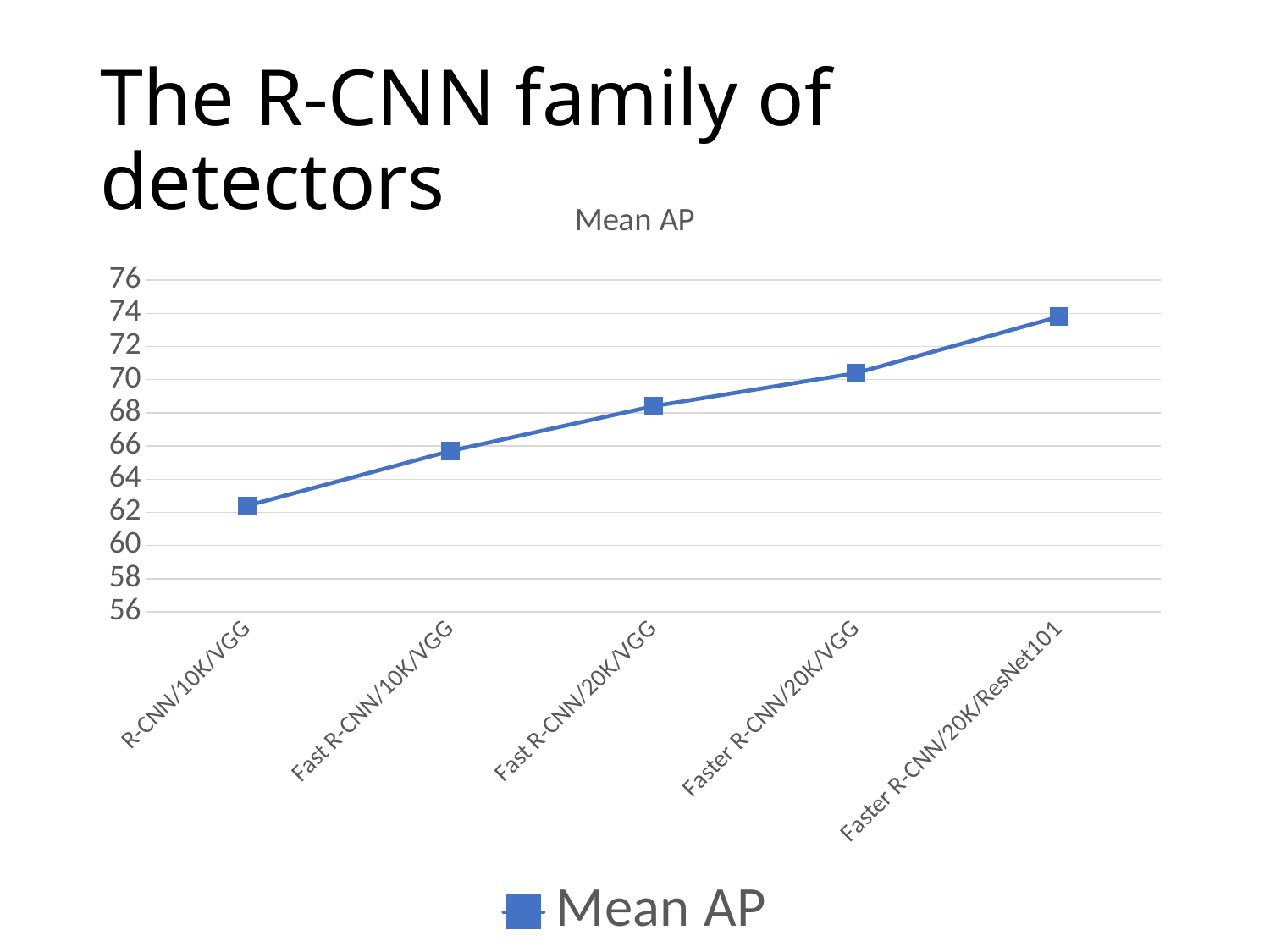
Which detector has the lowest Mean AP? R-CNN/10K/VGG How many series does the legend list? 1 Does Mean AP rise or fall from left to right across the detectors? rise Is the Mean AP for Fast R-CNN/20K/VGG greater or less than 70? less Is the Mean AP for R-CNN/10K/VGG greater or less than 64? less Is the Mean AP for Faster R-CNN/20K/ResNet101 greater or less than 72? greater What kind of chart is shown on the slide? line chart How many detectors (data points) are plotted on the chart? 5 What is the title of the chart? Mean AP Which detector has the highest Mean AP? Faster R-CNN/20K/ResNet101 Which has a higher Mean AP, Fast R-CNN/10K/VGG or Faster R-CNN/20K/VGG? Faster R-CNN/20K/VGG